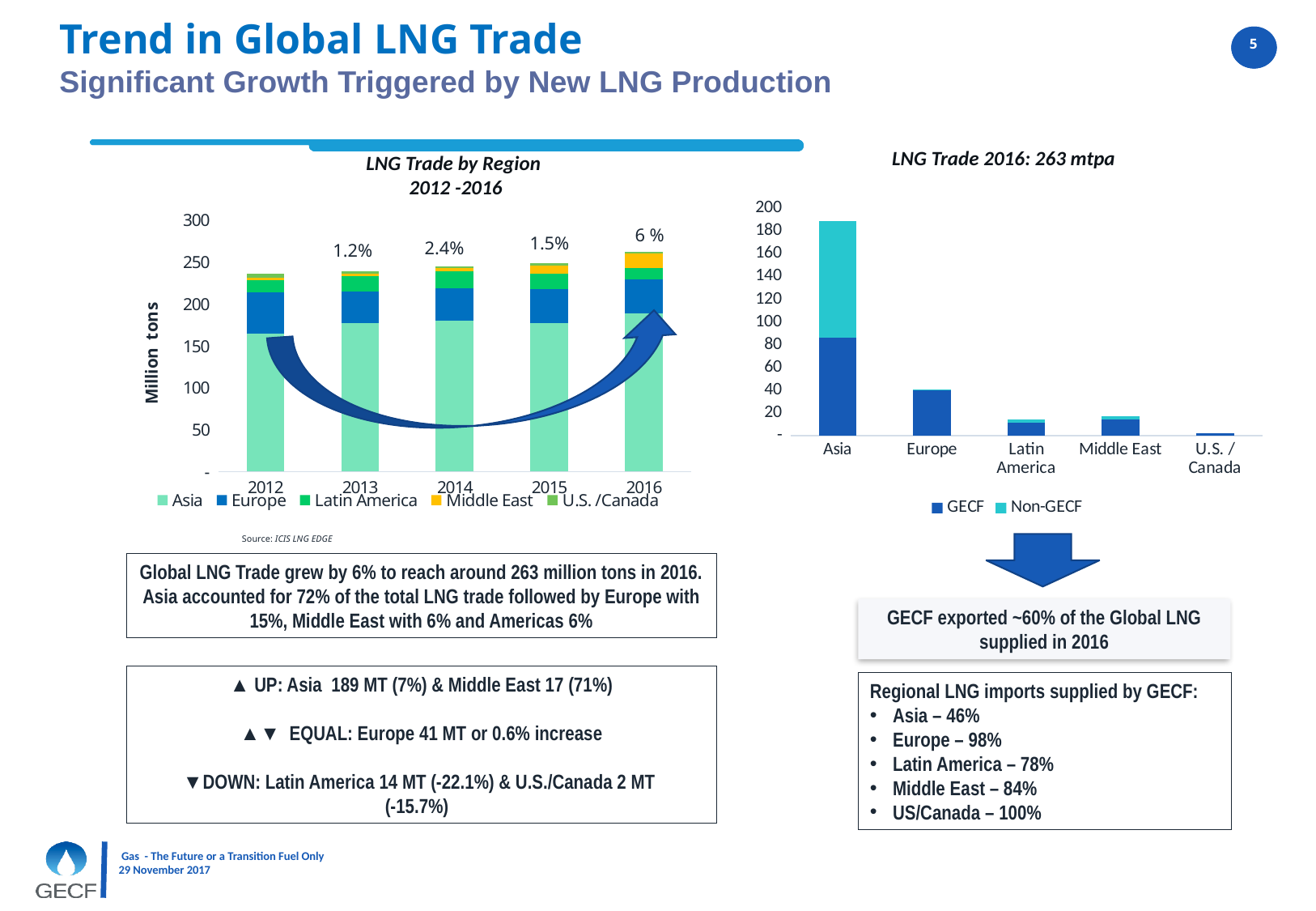
What kind of chart is the 'LNG Trade by Region 2012-2016' chart? bar chart How many series does the legend of the 'LNG Trade by Region 2012-2016' chart list? 5 What kind of chart is the 'LNG Trade 2016: 263 mtpa' chart? bar chart How many series does the legend of the 'LNG Trade 2016: 263 mtpa' chart list? 2 How many years are shown on the x axis of the 'LNG Trade by Region 2012-2016' chart? 5 In the 'LNG Trade by Region 2012-2016' chart, do the total bar heights rise or fall from 2012 to 2016? rise What is the y-axis title of the 'LNG Trade by Region 2012-2016' chart? Million tons In the 'LNG Trade by Region 2012-2016' chart, what growth percentage is printed above the 2016 bar? 6 % In the 'LNG Trade 2016: 263 mtpa' chart, which region has the tallest bar? Asia In the 'LNG Trade 2016: 263 mtpa' chart, is the total value for Europe greater or less than 60? less In the 'LNG Trade 2016: 263 mtpa' chart, which region has the shortest bar? U.S. / Canada In the 'LNG Trade by Region 2012-2016' chart, what growth percentage is printed above the 2013 bar? 1.2%